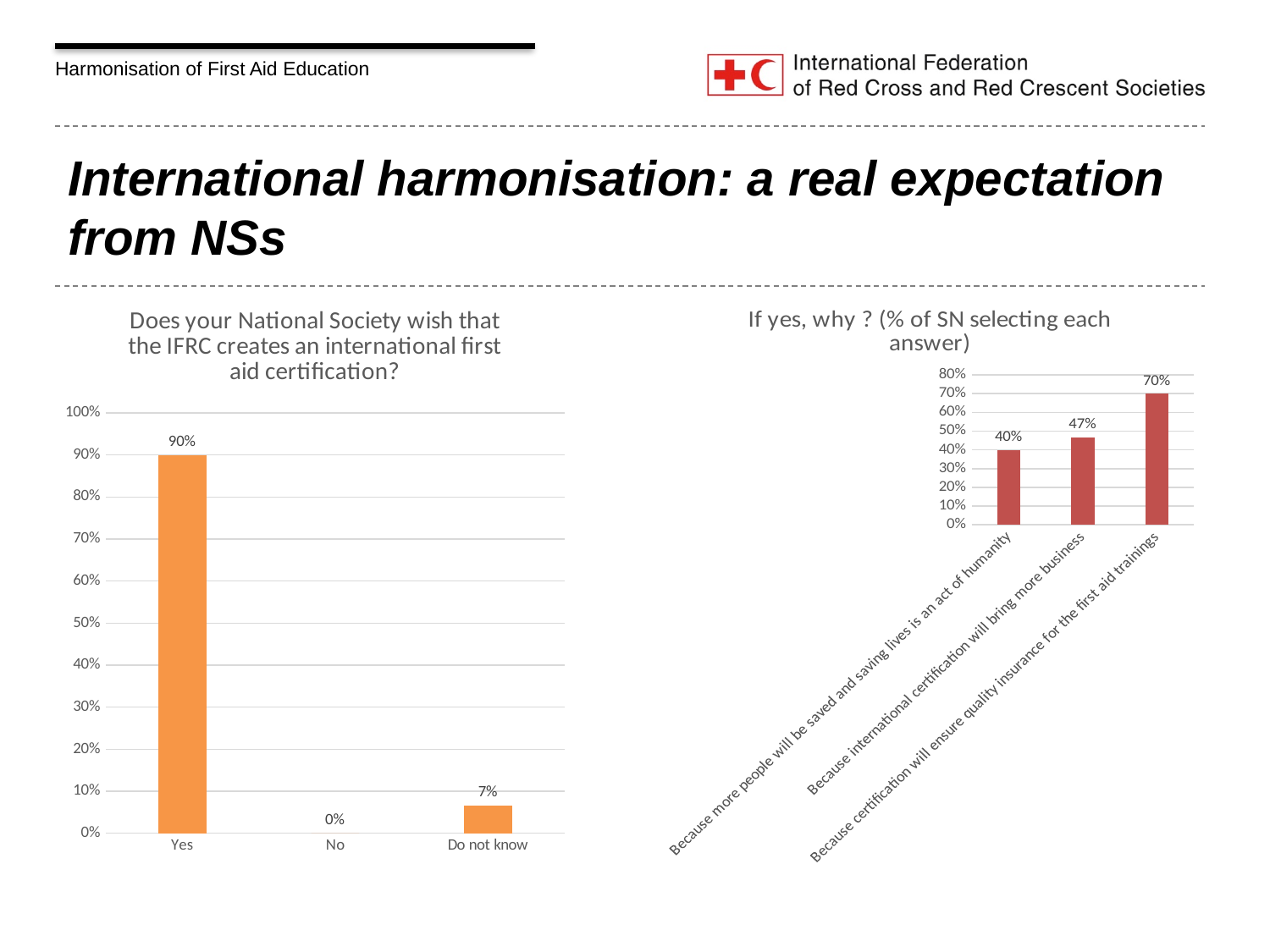
In the right chart 'If yes, why ? (% of SN selecting each answer)', what is the value for 'Because international certification will bring more business'? 47% In the left chart 'Does your National Society wish that the IFRC creates an international first aid certification?', how many categories are shown on the x axis? 3 In the right chart 'If yes, why ? (% of SN selecting each answer)', what is the difference between the highest and lowest values? 30% In the right chart 'If yes, why ? (% of SN selecting each answer)', what is the value for 'Because certification will ensure quality insurance for the first aid trainings'? 70% In the left chart 'Does your National Society wish that the IFRC creates an international first aid certification?', which category has the highest value? Yes In the left chart 'Does your National Society wish that the IFRC creates an international first aid certification?', what is the value for No? 0% In the left chart 'Does your National Society wish that the IFRC creates an international first aid certification?', what is the value for Yes? 90% What kind of chart is the right chart 'If yes, why ? (% of SN selecting each answer)'? bar chart In the left chart 'Does your National Society wish that the IFRC creates an international first aid certification?', what is the difference between the values for Yes and Do not know? 83% In the right chart 'If yes, why ? (% of SN selecting each answer)', do the values rise or fall from left to right along the x axis? rise In the right chart 'If yes, why ? (% of SN selecting each answer)', which category has the lowest value? Because more people will be saved and saving lives is an act of humanity In the left chart 'Does your National Society wish that the IFRC creates an international first aid certification?', what is the value for Do not know? 7%